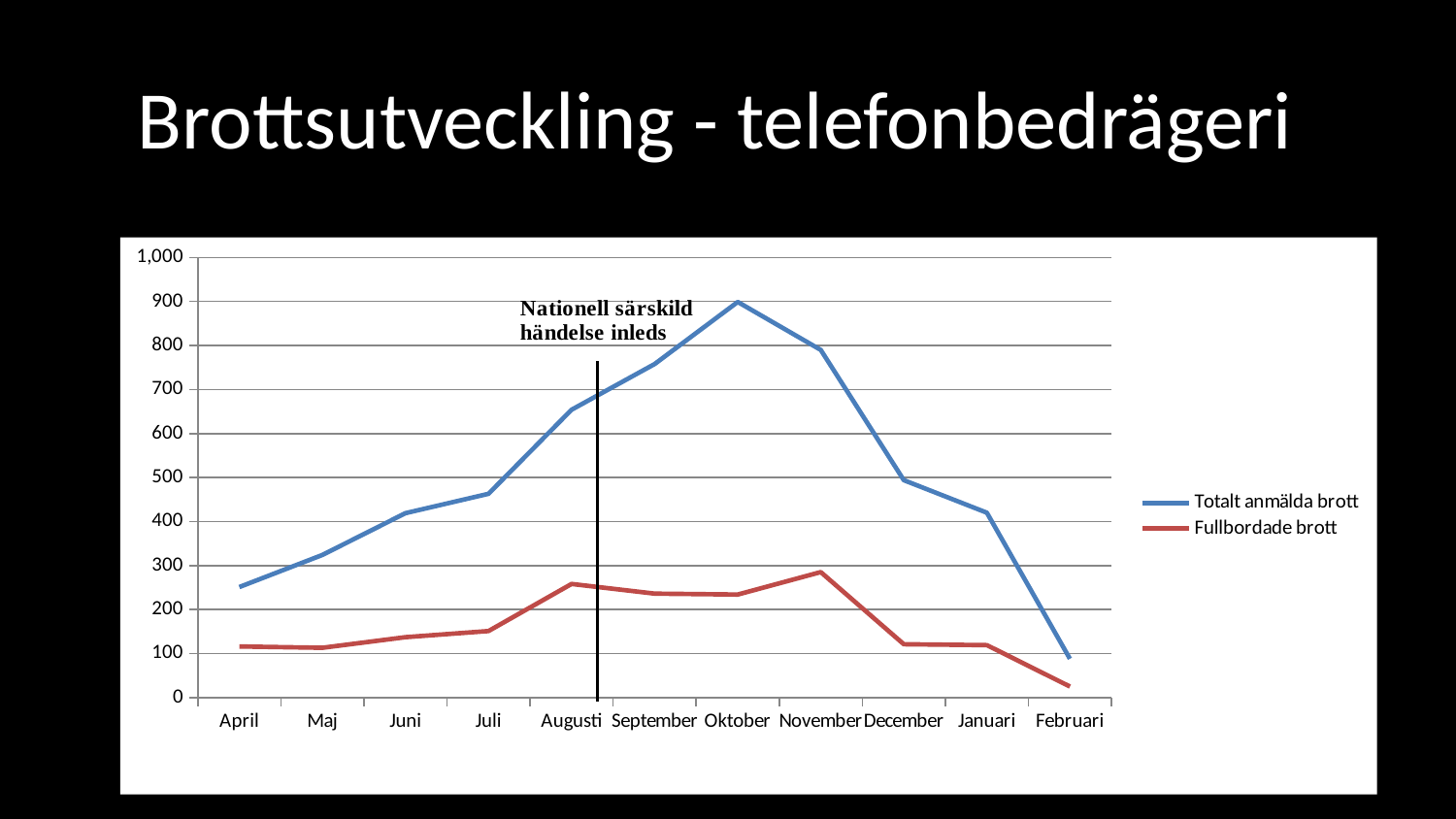
How many series does the legend list? 2 Is the value for Fullbordade brott in November greater or less than 200? greater In which month is the Totalt anmälda brott series at its lowest? Februari What kind of chart is shown on the slide? line chart In which month does the Totalt anmälda brott series reach its highest value? Oktober Is the value for Totalt anmälda brott in April greater or less than 300? less How many months are plotted along the x axis? 11 Is the value for Totalt anmälda brott in Oktober greater or less than 800? greater Which is larger: Totalt anmälda brott in Maj or Totalt anmälda brott in Juli? Juli What text does the annotation next to the vertical line in the chart say? Nationell särskild händelse inleds Does the Totalt anmälda brott series rise or fall from April to Oktober? rise In which month does the Fullbordade brott series reach its highest value? November